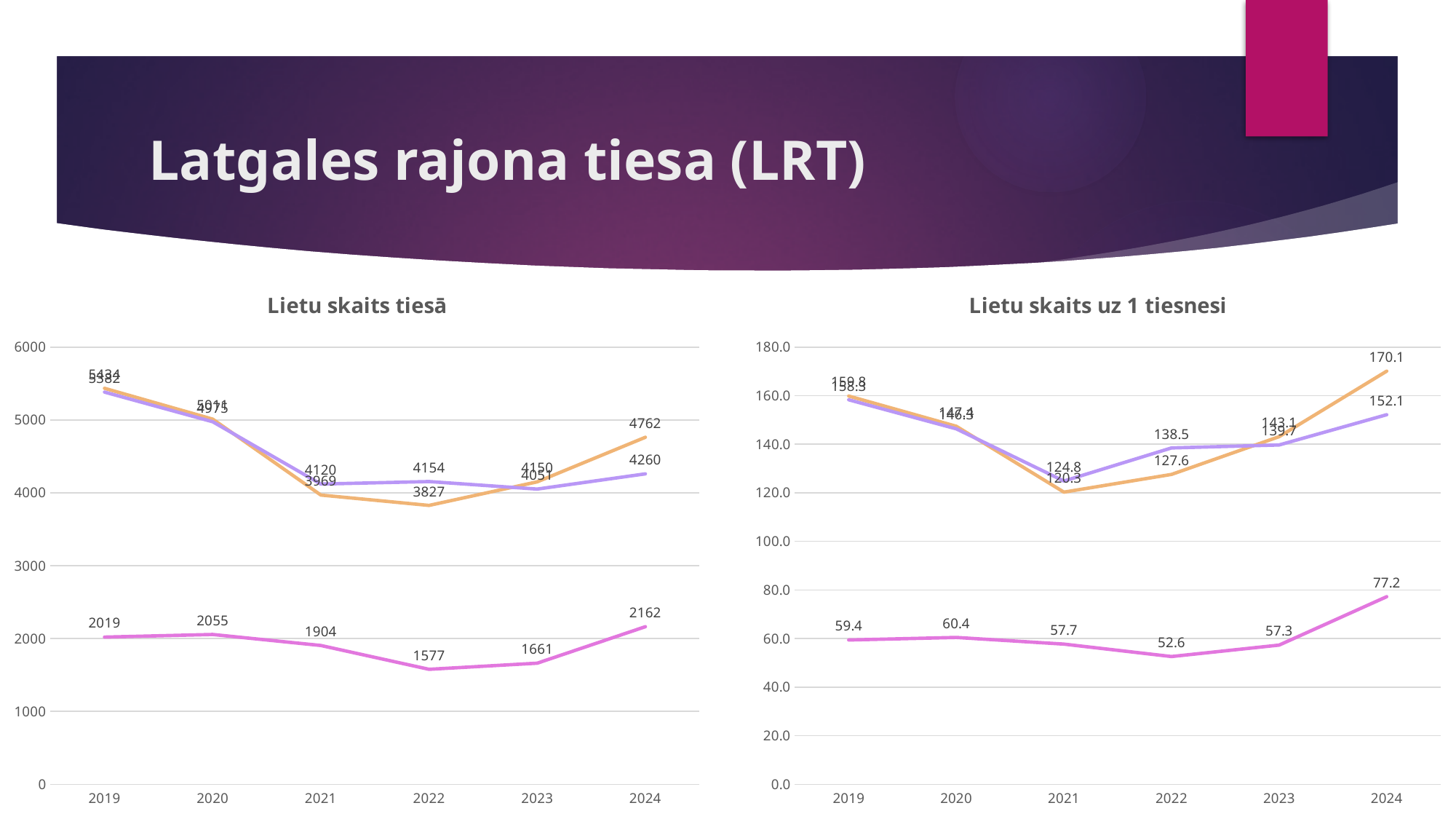
In the "Lietu skaits uz 1 tiesnesi" chart, is the orange line's value in 2021 greater or less than the purple line's value in 2021? less In the "Lietu skaits uz 1 tiesnesi" chart, what is the value of the orange line in 2024? 170.1 In the "Lietu skaits uz 1 tiesnesi" chart, what is the value of the pink line in 2022? 52.6 In the "Lietu skaits tiesā" chart, how many years are shown on the x axis? 6 In the "Lietu skaits tiesā" chart, what is the value of the orange line in 2024? 4762 In the "Lietu skaits uz 1 tiesnesi" chart, which year has the lowest value on the pink line? 2022 What kind of chart is "Lietu skaits tiesā"? line chart How many lines are plotted in the "Lietu skaits tiesā" chart? 3 In the "Lietu skaits uz 1 tiesnesi" chart, does the pink line rise or fall from 2023 to 2024? rise In the "Lietu skaits tiesā" chart, what is the difference between the orange and purple lines in 2024? 502 In the "Lietu skaits tiesā" chart, what is the value of the pink line in 2022? 1577 In the "Lietu skaits tiesā" chart, which year has the highest value on the pink line? 2024